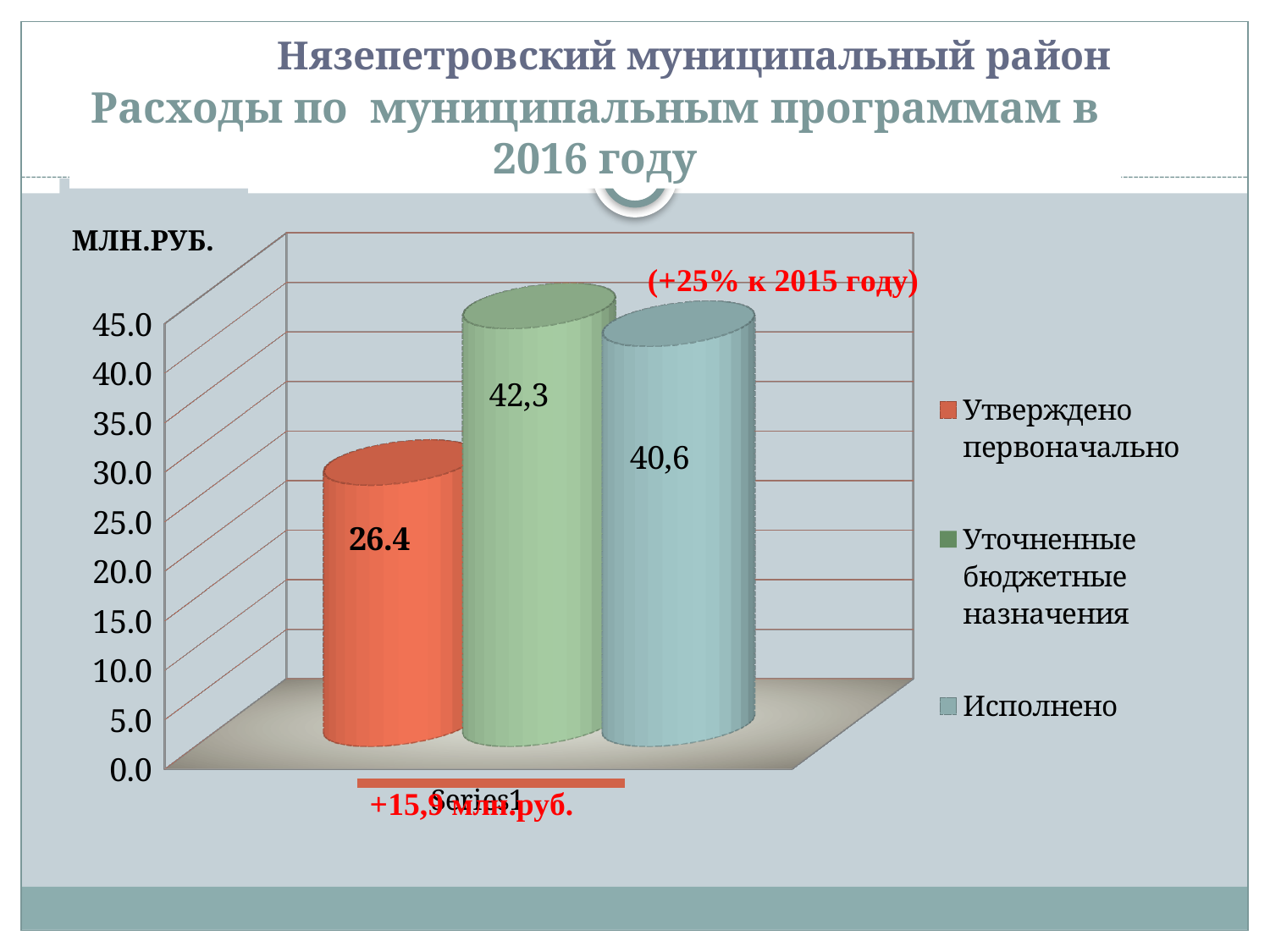
What unit is shown above the vertical axis of the chart? МЛН.РУБ. Which is larger, the value for "Исполнено" or the value for "Утверждено первоначально"? Исполнено What is the value for "Исполнено"? 40,6 Which series has the lowest value? Утверждено первоначально What is the difference between the value for "Уточненные бюджетные назначения" and the value for "Утверждено первоначально"? 15,9 Which series has the highest value? Уточненные бюджетные назначения How many series does the legend list? 3 Is the value for "Утверждено первоначально" greater or less than 30.0? less What is the value for "Уточненные бюджетные назначения"? 42,3 What is the difference between the value for "Уточненные бюджетные назначения" and the value for "Исполнено"? 1,7 What kind of chart is shown on the slide? bar chart What is the value for "Утверждено первоначально"? 26.4